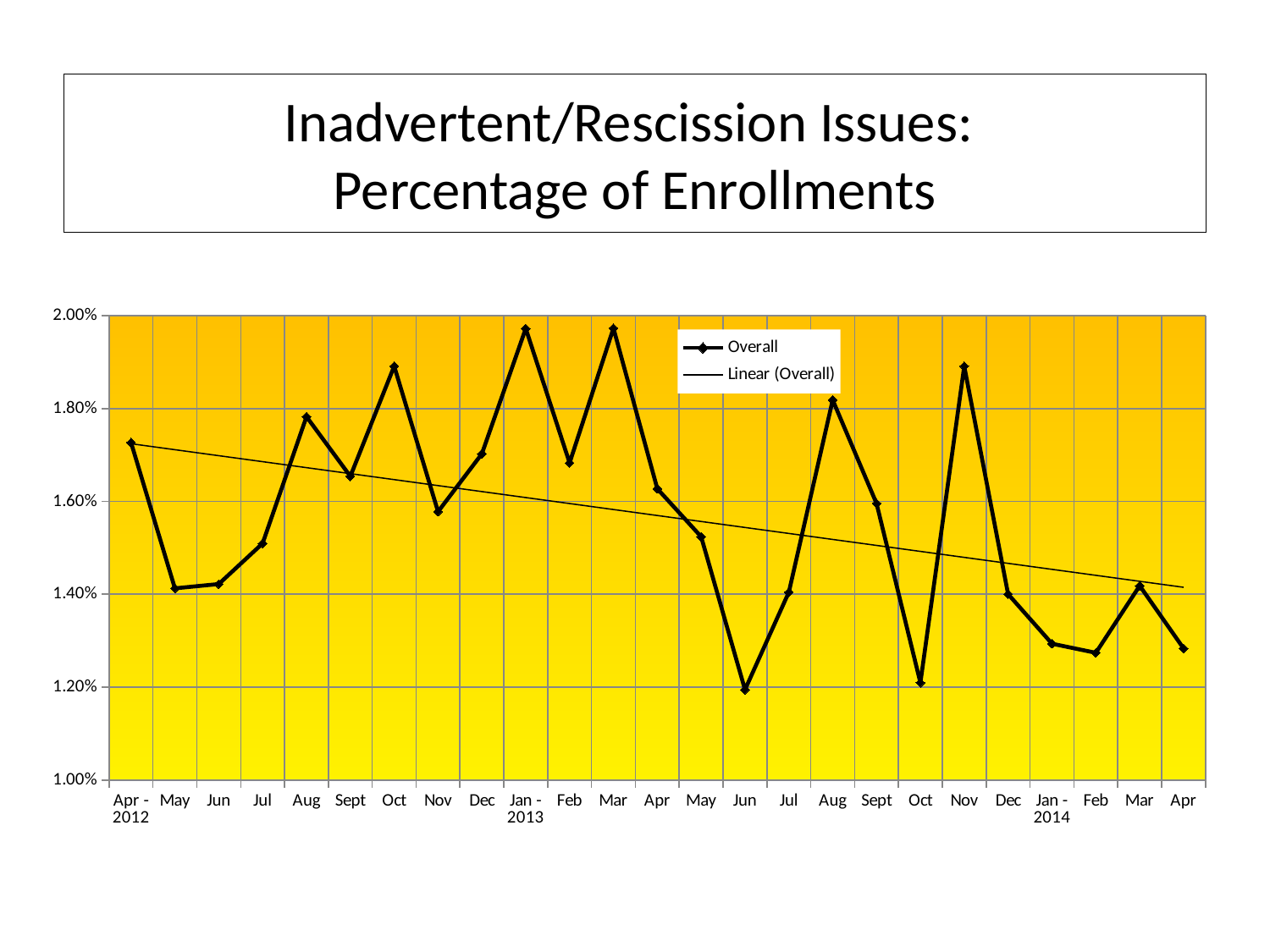
Which is larger, the value for Oct 2012 or the value for Nov 2012? Oct 2012 Is the value for Oct 2012 greater or less than 1.80%? greater Is the value for Aug 2012 greater or less than 1.60%? greater Which is larger, the value for Jul 2013 or the value for Aug 2013? Aug 2013 Is the value for Apr 2014 greater or less than 1.40%? less How many monthly data points are plotted on the chart? 25 What is the title of the chart? Inadvertent/Rescission Issues: Percentage of Enrollments Does the linear trend line rise or fall from Apr 2012 to Apr 2014? fall How many series does the legend list? 2 What kind of chart is shown on the slide? line chart